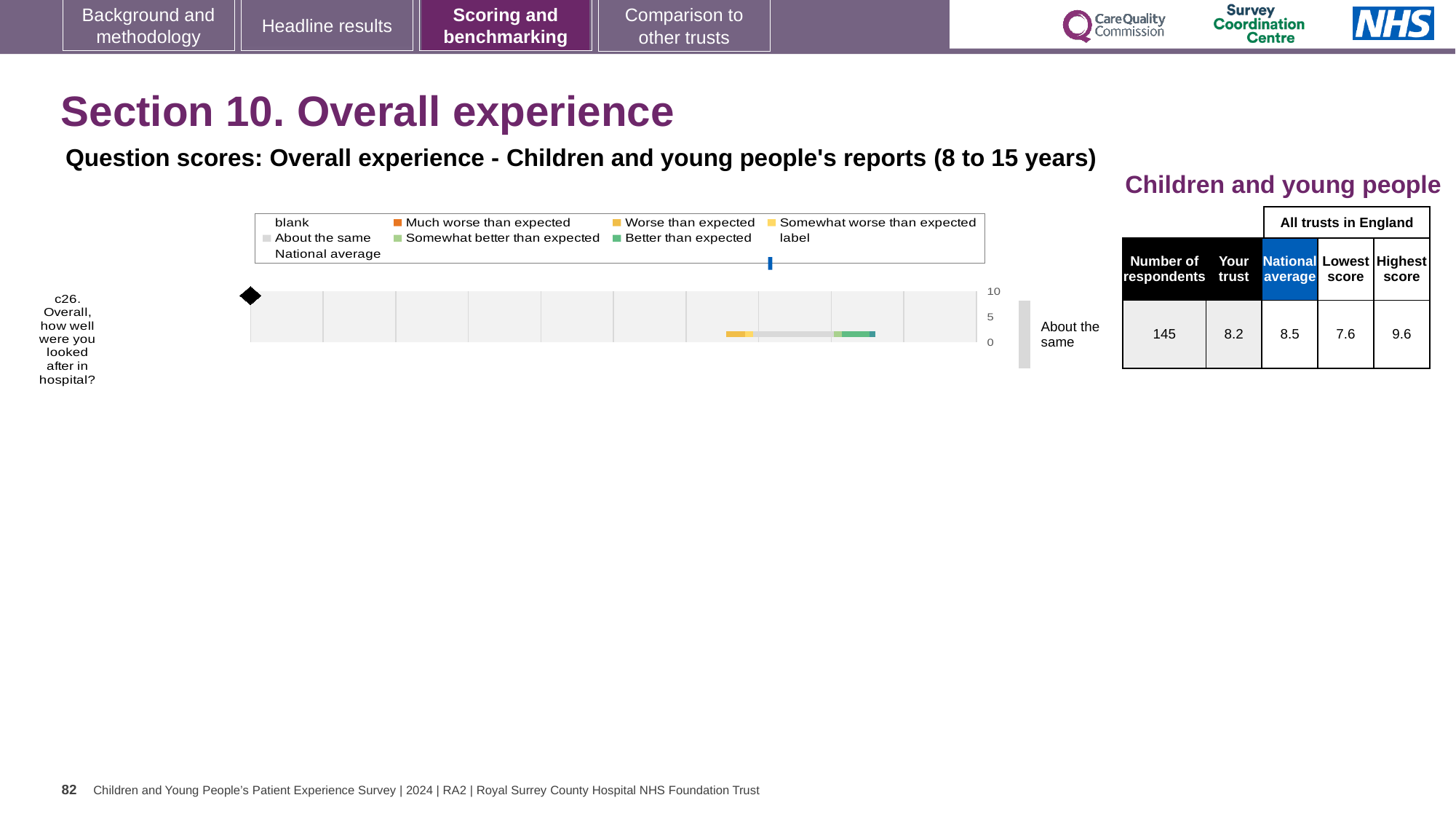
What kind of chart is shown on the slide for question c26? bar chart What is the national average score for question c26 in the table beside the chart? 8.5 What is the 'Your trust' score for question c26 in the table beside the chart? 8.2 What is the difference between the highest score (9.6) and the lowest score (7.6) for question c26? 2.0 What benchmark category is shown next to the bar for question c26? About the same What is the lowest score among all trusts in England for question c26? 7.6 How many respondents answered question c26? 145 Which is larger for question c26: the 'Your trust' score or the national average? National average How many survey questions are plotted in the chart on the slide? 1 What is the difference between the national average (8.5) and the 'Your trust' score (8.2) for question c26? 0.3 What is the highest score among all trusts in England for question c26? 9.6 In the chart legend, what colour represents 'Much worse than expected'? Orange